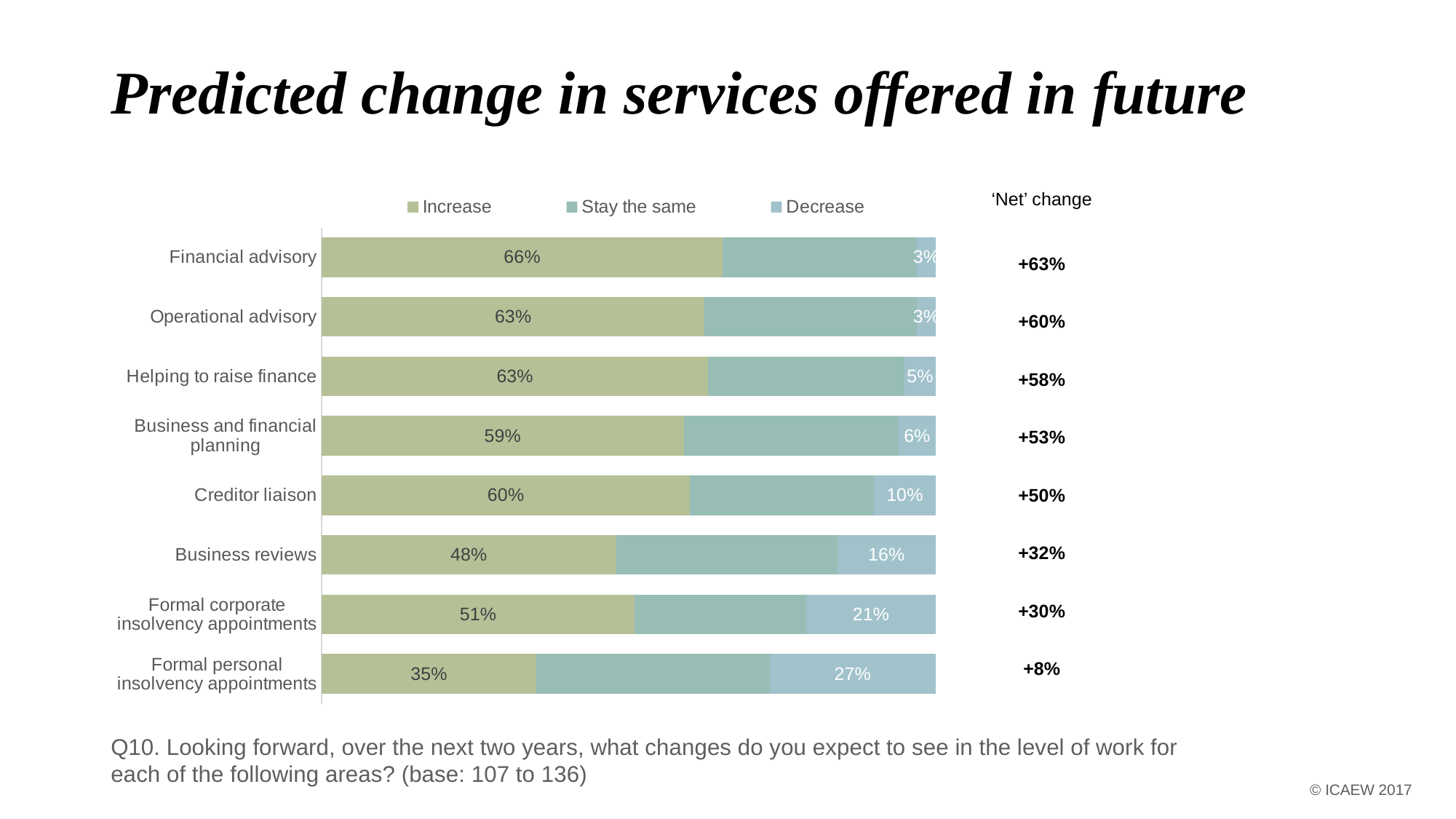
What is the Decrease value for Formal personal insolvency appointments? 27% What percentage of respondents expect an increase in Financial advisory work? 66% How many service areas are shown in the chart? 8 Which service area has the highest Increase percentage? Financial advisory What type of chart is shown on the slide? Stacked bar chart What are the three legend entries of the chart? Increase, Stay the same, Decrease How many series does the legend list? 3 What is the 'Net' change shown for Business reviews? +32% Which has a higher Increase percentage: Creditor liaison or Business and financial planning? Creditor liaison What is the difference between the Increase percentage for Financial advisory and for Formal personal insolvency appointments? 31 percentage points Which service area has the largest Decrease percentage? Formal personal insolvency appointments Which service area has the lowest Increase percentage? Formal personal insolvency appointments